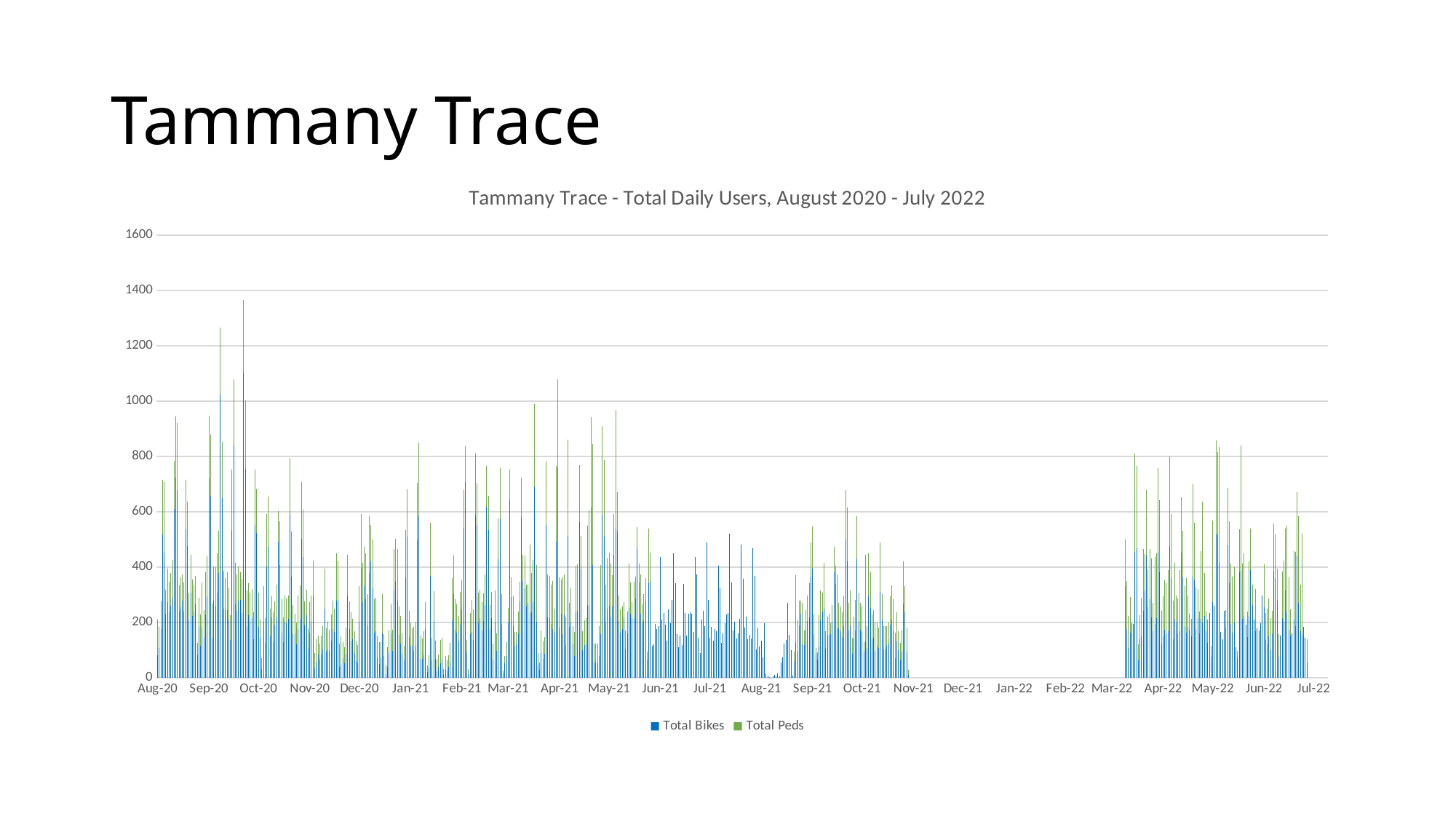
What is the title of the chart? Tammany Trace - Total Daily Users, August 2020 - July 2022 Between which two x-axis labels is there a gap with no bars plotted? Nov-21 and Mar-22 How many month labels are shown on the x axis? 24 How many series does the legend list? 2 What kind of chart is shown on the slide? Bar chart Is the highest value on the chart greater or less than 1400? less Is the tallest Total Bikes bar greater or less than 1200? less What is the highest value shown on the y axis? 1600 Is the tallest Total Bikes bar greater or less than 1000? greater